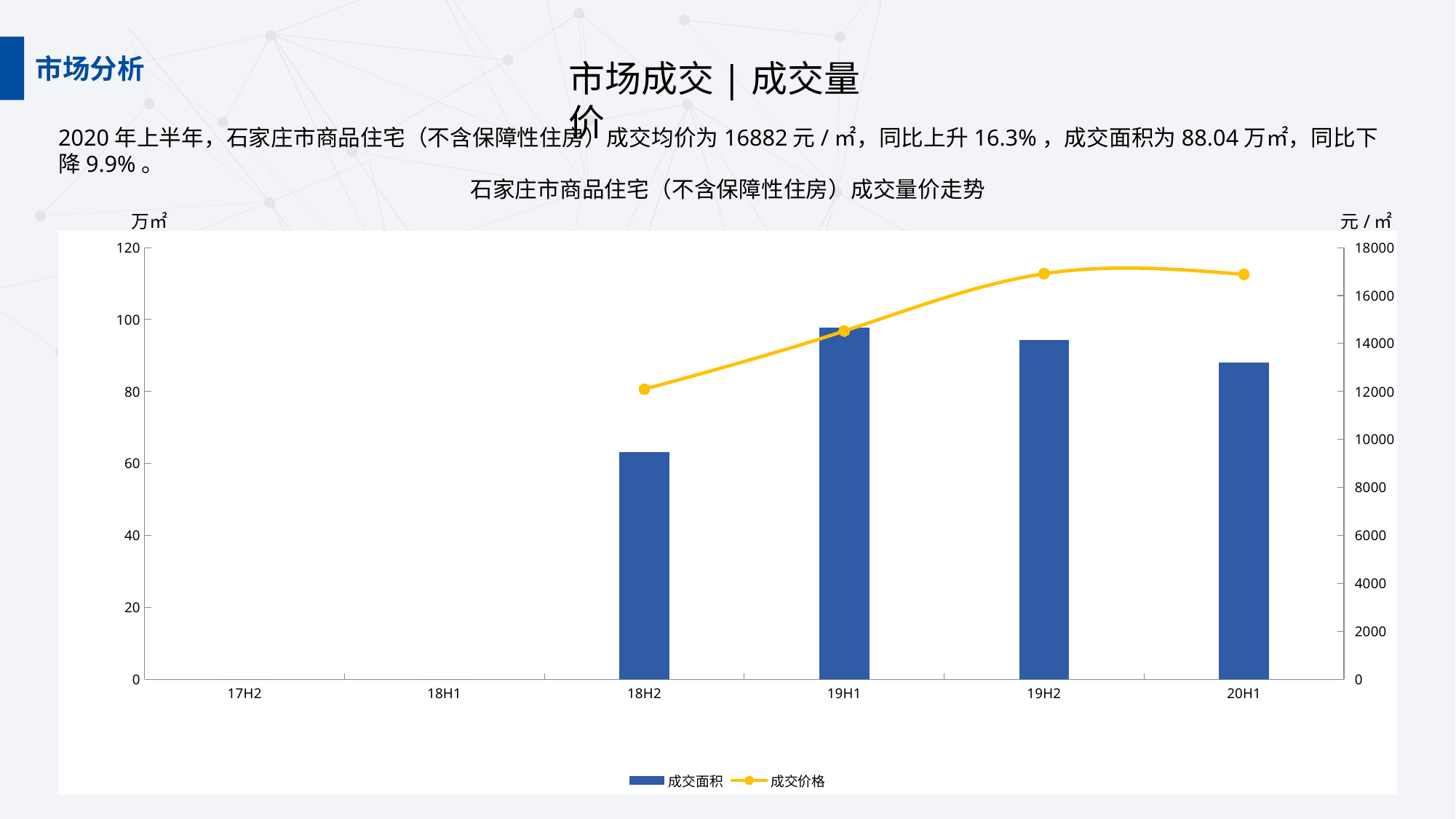
How many series does the chart legend list? 2 Which period has the highest 成交面积 bar? 19H1 Is the 成交面积 value for 20H1 greater or less than 80? greater Is the 成交面积 value for 18H2 greater or less than 80? less Which period has the lowest 成交面积 bar? 18H2 Which period has the lowest 成交价格 point? 18H2 How many periods have a 成交面积 bar plotted? 4 What kind of chart is shown on the slide? A combined bar and line chart What are the two series named in the legend? 成交面积 and 成交价格 Is the 成交价格 value for 19H2 greater or less than 16000? greater Does the 成交价格 line rise or fall from 18H2 to 19H2? Rise Which is larger, the 成交面积 for 19H1 or for 20H1? 19H1